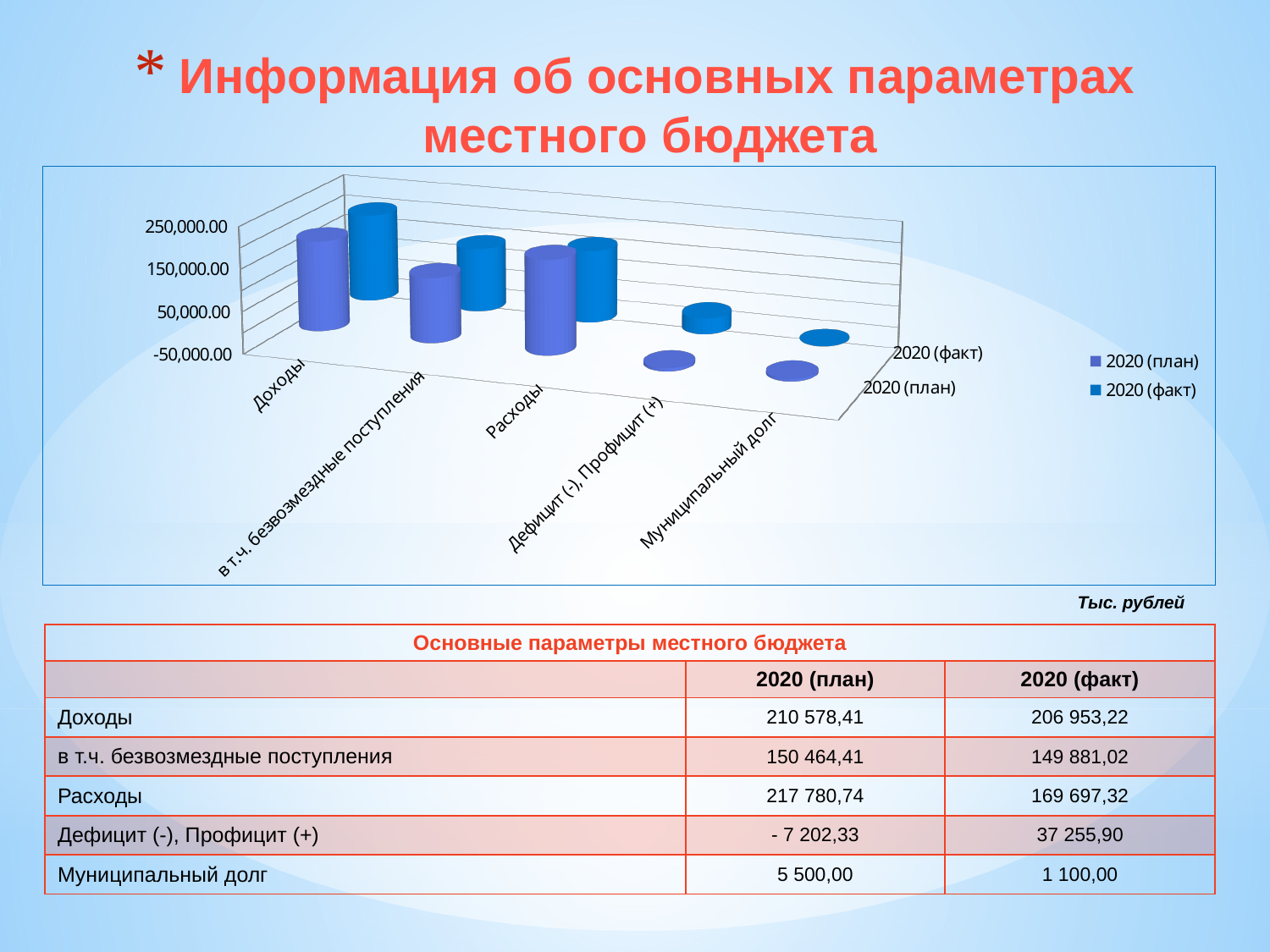
Which category has the highest 2020 (факт) value? Доходы What is the 2020 (факт) value for Расходы? 169 697,32 What are the two series named in the chart legend? 2020 (план) and 2020 (факт) Which is larger for Расходы, the 2020 (план) value or the 2020 (факт) value? 2020 (план) What kind of chart is shown on the slide? bar chart What is the difference between the 2020 (план) and 2020 (факт) values for Муниципальный долг? 4 400,00 How many categories are plotted along the x axis of the chart? 5 Is the 2020 (план) value for Муниципальный долг greater or less than 50,000.00? less What is the 2020 (план) value for Дефицит (-), Профицит (+)? - 7 202,33 How many series does the chart legend list? 2 Which category has the lowest 2020 (факт) value? Муниципальный долг What is the 2020 (план) value for Доходы? 210 578,41